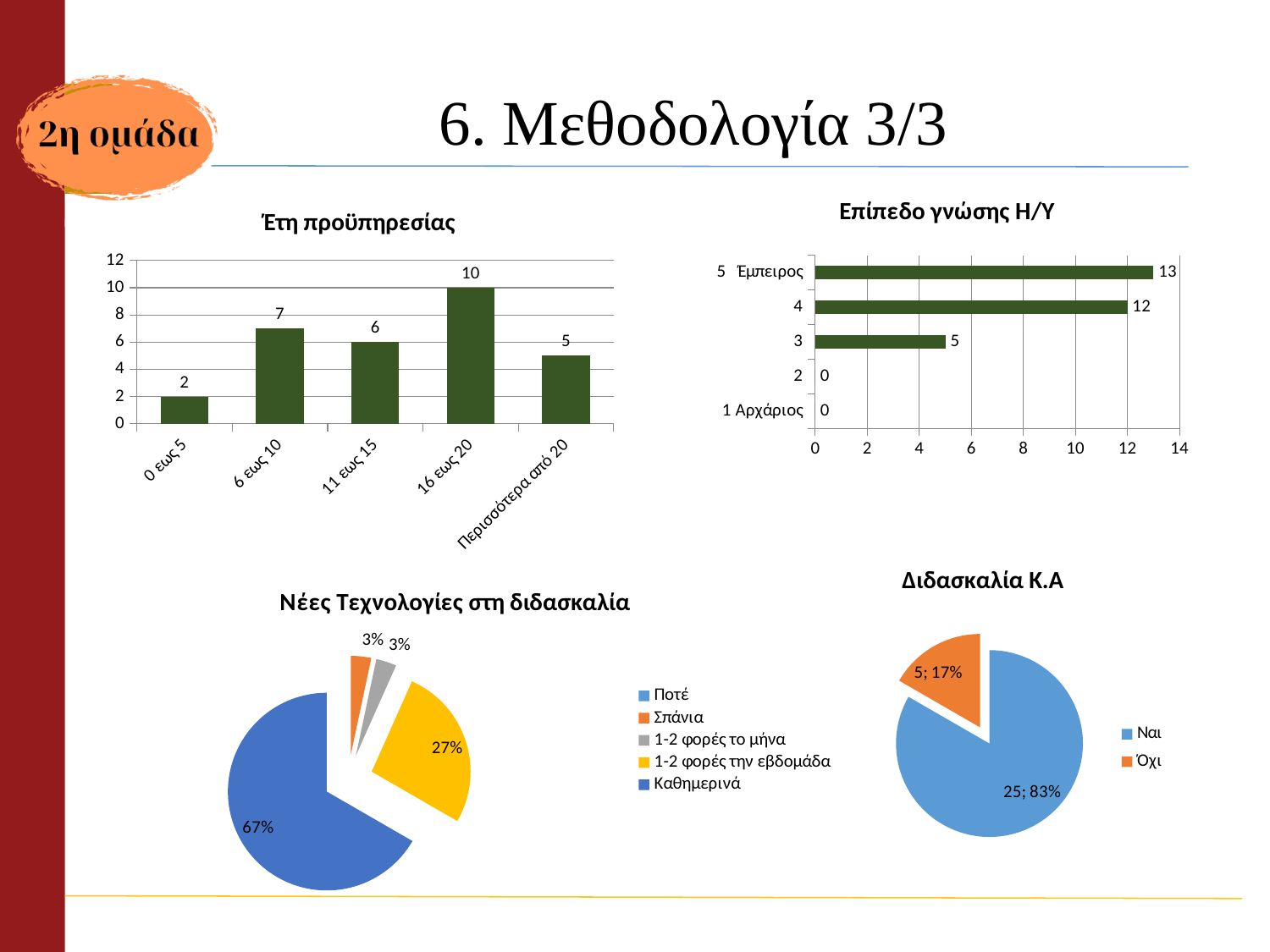
In the chart titled 'Επίπεδο γνώσης Η/Υ', what is the value for '5 Έμπειρος'? 13 How many categories are shown in the chart titled 'Έτη προϋπηρεσίας'? 5 In the pie chart titled 'Νέες Τεχνολογίες στη διδασκαλία', what share does '1-2 φορές την εβδομάδα' have? 27% In the chart titled 'Έτη προϋπηρεσίας', what is the value for '16 εως 20'? 10 In the chart titled 'Έτη προϋπηρεσίας', which category has the lowest value? 0 εως 5 In the chart titled 'Επίπεδο γνώσης Η/Υ', which is larger, the value for '4' or the value for '3'? 4 In the chart titled 'Επίπεδο γνώσης Η/Υ', what is the value for '1 Αρχάριος'? 0 How many entries does the legend of the chart titled 'Νέες Τεχνολογίες στη διδασκαλία' list? 5 What kind of chart is the chart titled 'Επίπεδο γνώσης Η/Υ'? bar chart In the chart titled 'Έτη προϋπηρεσίας', what is the difference between the values for '6 εως 10' and '11 εως 15'? 1 In the pie chart titled 'Νέες Τεχνολογίες στη διδασκαλία', what share does 'Καθημερινά' have? 67% In the pie chart titled 'Διδασκαλία Κ.Α', what share does 'Όχι' have? 17%